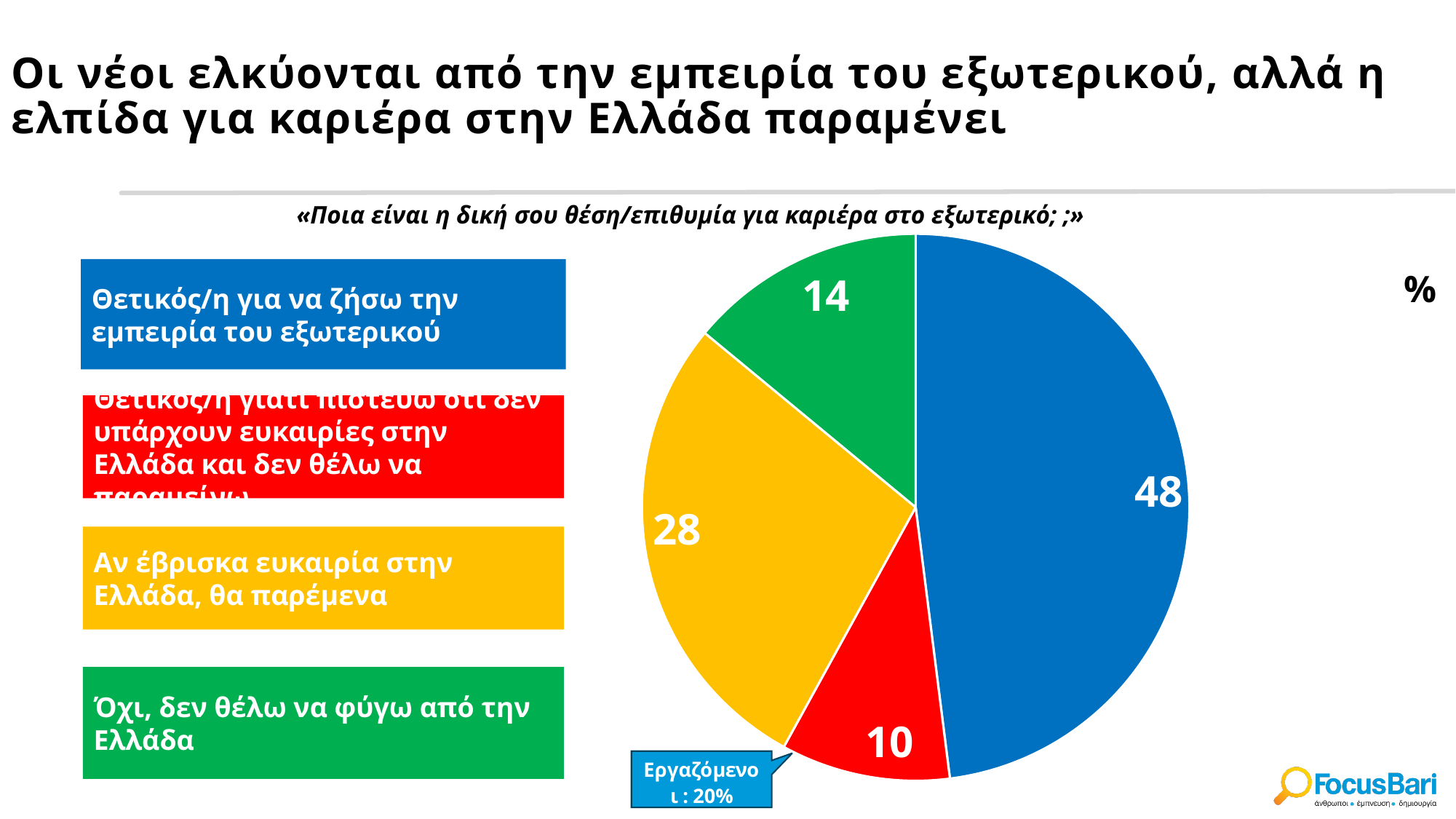
How many slices does the pie chart have? 4 What is the combined value of the yellow and green slices? 42 What is the value of the yellow slice (Αν έβρισκα ευκαιρία στην Ελλάδα, θα παρέμενα)? 28 What is the value of the blue slice (Θετικός/η για να ζήσω την εμπειρία του εξωτερικού)? 48 What value does the callout box below the pie chart give for 'Εργαζόμενοι'? 20% Which category has the largest share of the pie? Θετικός/η για να ζήσω την εμπειρία του εξωτερικού What is the value of the green slice (Όχι, δεν θέλω να φύγω από την Ελλάδα)? 14 Which is larger, the green slice or the red slice? the green slice Which slice of the pie is the smallest? the red slice (10) What is the value of the red slice? 10 What is the difference between the blue slice (48) and the yellow slice (28)? 20 What type of chart is shown on the slide? pie chart